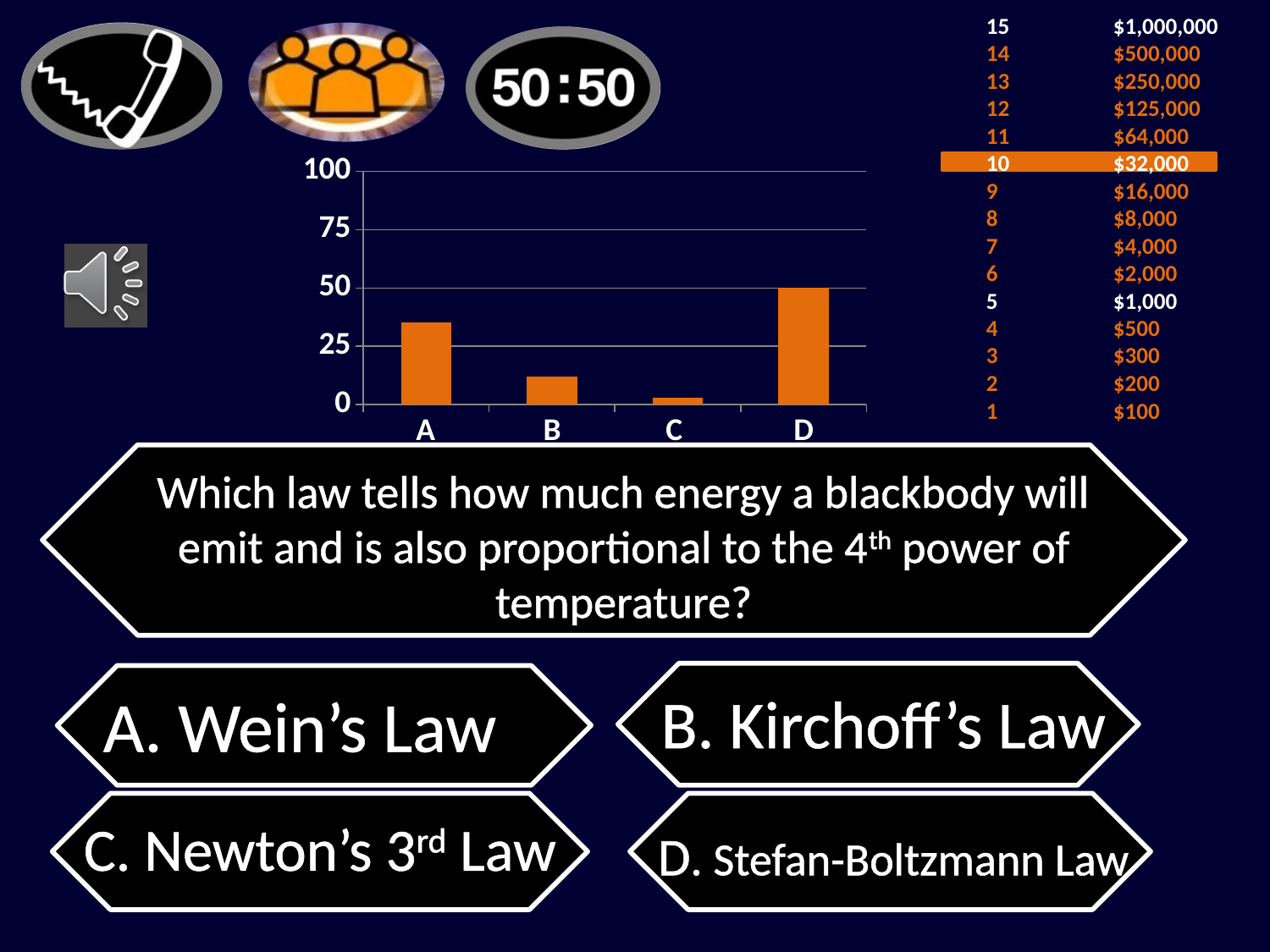
Is the value for A greater or less than 50? less What is the value for category D in the bar chart? 50 Is the value for B greater or less than 25? less Which is larger, the value for B or the value for C? B What kind of chart is shown on the slide? bar chart Which category has the highest bar in the chart? D How many categories are shown on the x axis of the bar chart? 4 What is the highest value shown on the y axis of the chart? 100 Is the value for A greater or less than 25? greater Which category has the lowest bar in the chart? C Which is larger, the value for A or the value for B? A